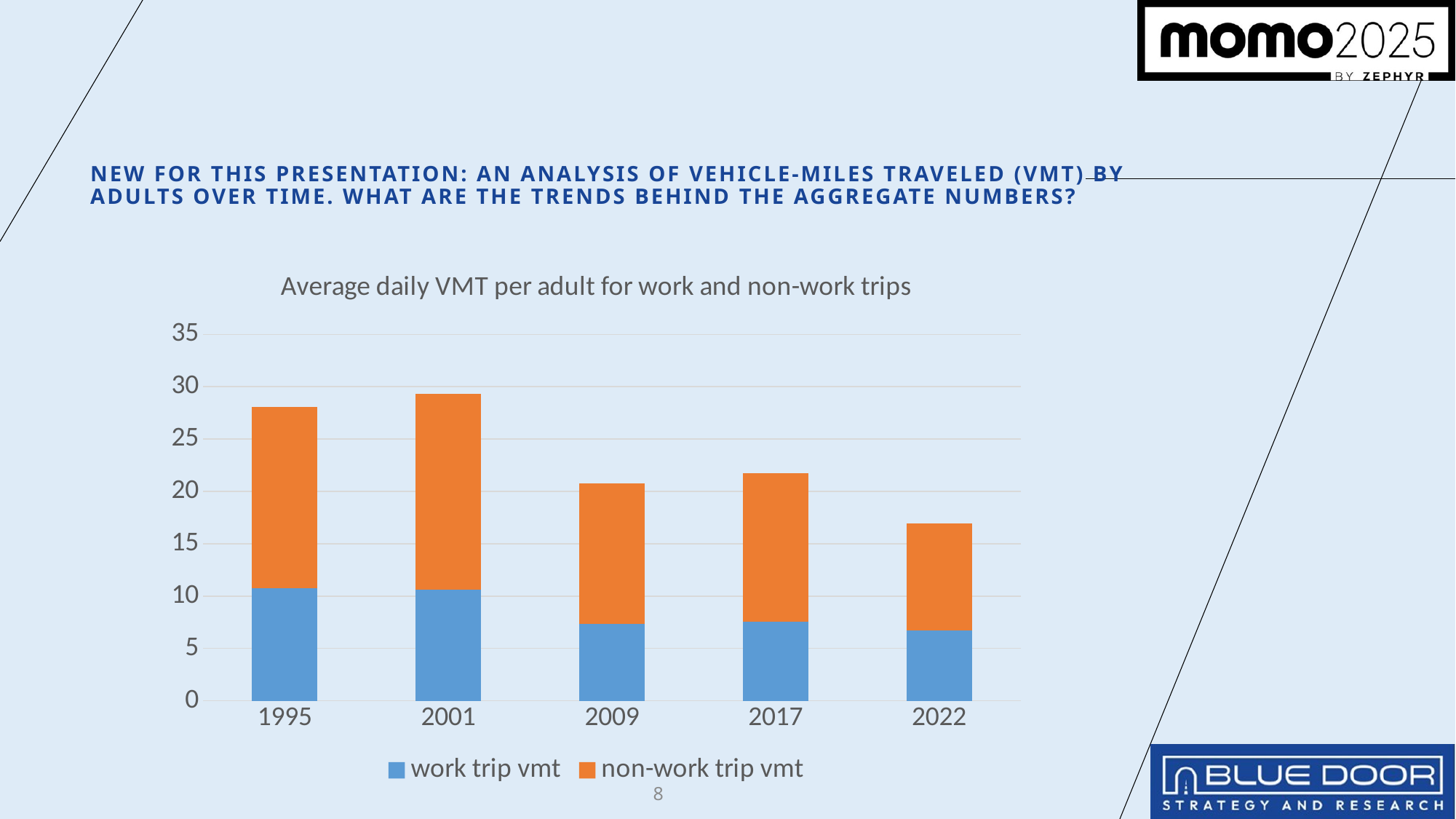
What is the title of the chart? Average daily VMT per adult for work and non-work trips Which colour represents non-work trip VMT in the chart? Orange Is the work trip VMT for 2009 greater or less than 10? less Which year has the lowest total average daily VMT per adult? 2022 Is the total average daily VMT per adult for 2001 greater or less than 25? greater Which year has the larger total average daily VMT per adult, 1995 or 2022? 1995 Is the total average daily VMT per adult for 2022 greater or less than 20? less Which year has the larger work trip VMT, 1995 or 2022? 1995 What kind of chart is shown on the slide? Stacked bar chart How many series does the chart legend list? 2 Which year has the highest total average daily VMT per adult? 2001 How many years are shown on the x axis of the chart? 5